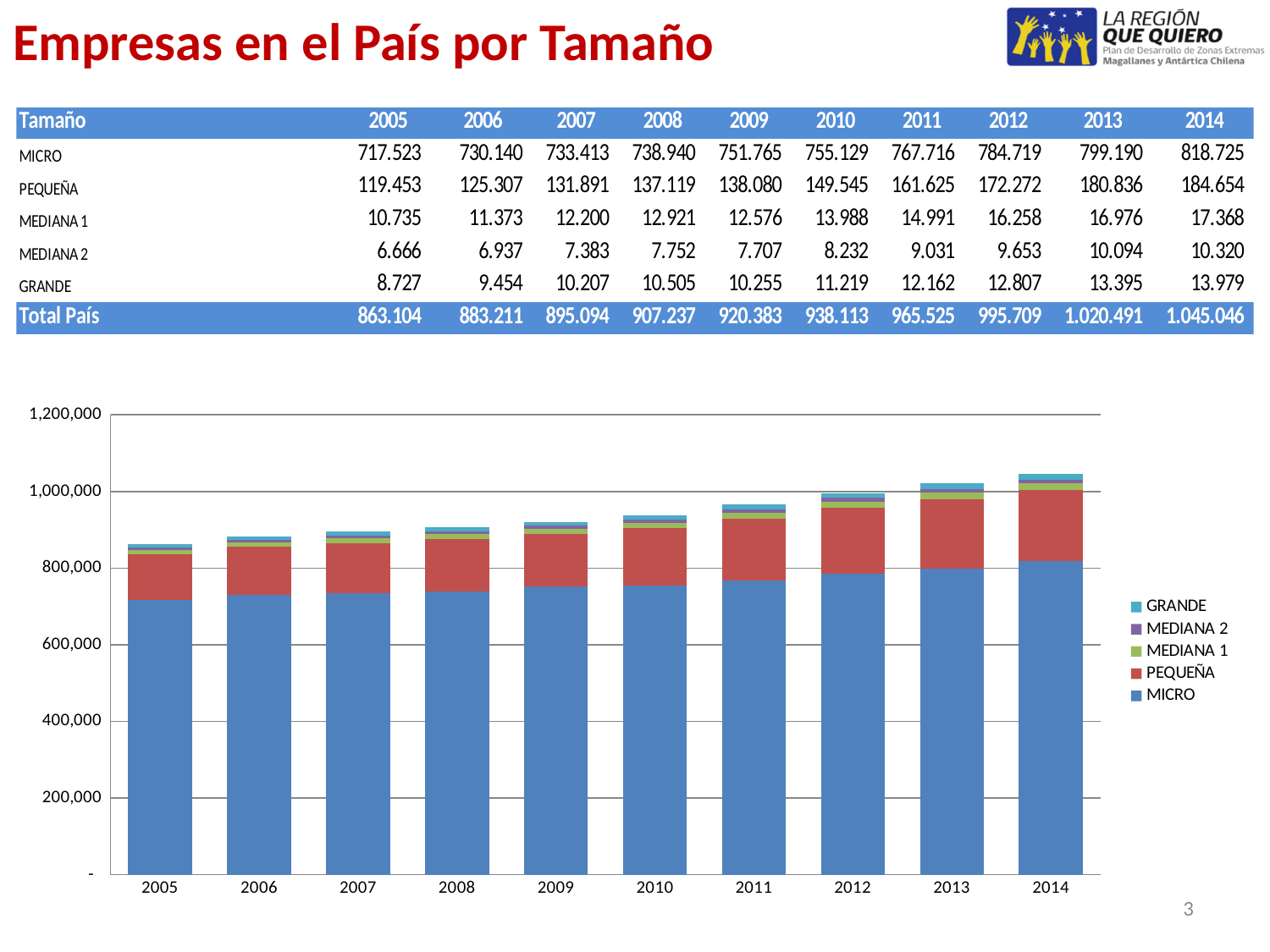
Is the MICRO value for 2005 greater or less than 800,000? less In 2014, which is larger: the PEQUEÑA segment or the MEDIANA 1 segment? PEQUEÑA What is the value of the MICRO segment for 2014? 818.725 What kind of chart is shown on the slide? bar chart Which year has the tallest stacked bar? 2014 What is the total of the stacked bar for 2010? 938.113 Which year has the shortest stacked bar? 2005 How many years are shown along the x axis of the chart? 10 Is the total value for 2014 greater or less than 1,000,000? greater Do the total heights of the stacked bars rise or fall from 2005 to 2014? rise How many series does the chart legend list? 5 What is the difference between the Total País for 2014 and for 2005? 181.942